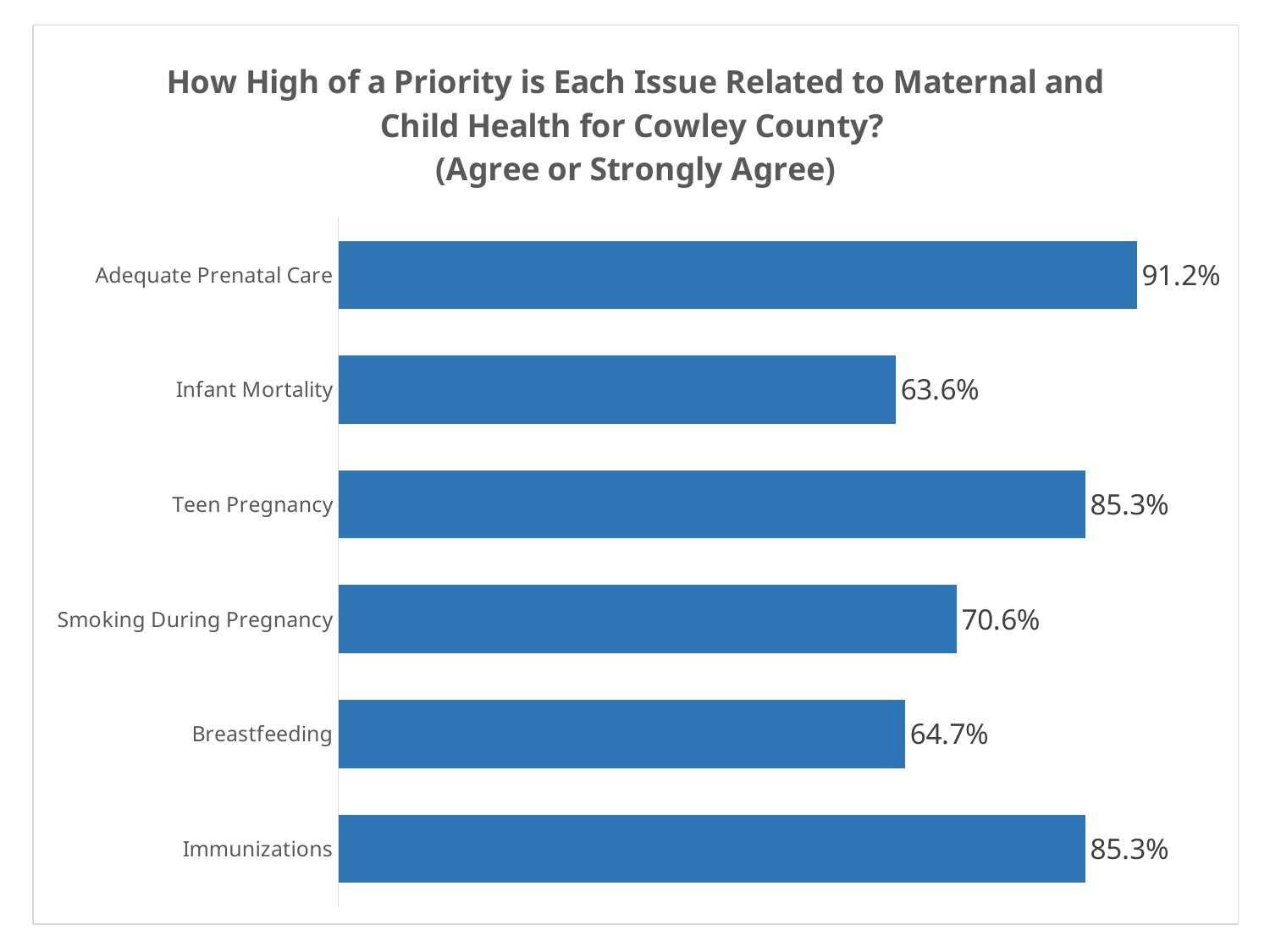
What type of chart is shown on the slide? Bar chart Which has a higher value, Smoking During Pregnancy or Breastfeeding? Smoking During Pregnancy Which two issues share the same value of 85.3%? Teen Pregnancy and Immunizations What is the value shown for Breastfeeding? 64.7% What is the difference in percentage points between Teen Pregnancy and Smoking During Pregnancy? 14.7 What percentage of respondents agreed or strongly agreed that Adequate Prenatal Care is a high priority? 91.2% How many issues are shown in the chart? 6 Which issue has the lowest percentage of agreement? Infant Mortality What is the value shown for Infant Mortality? 63.6% Which issue has the highest percentage of agreement? Adequate Prenatal Care What is the difference in percentage points between Adequate Prenatal Care and Infant Mortality? 27.6 What is the value shown for Smoking During Pregnancy? 70.6%